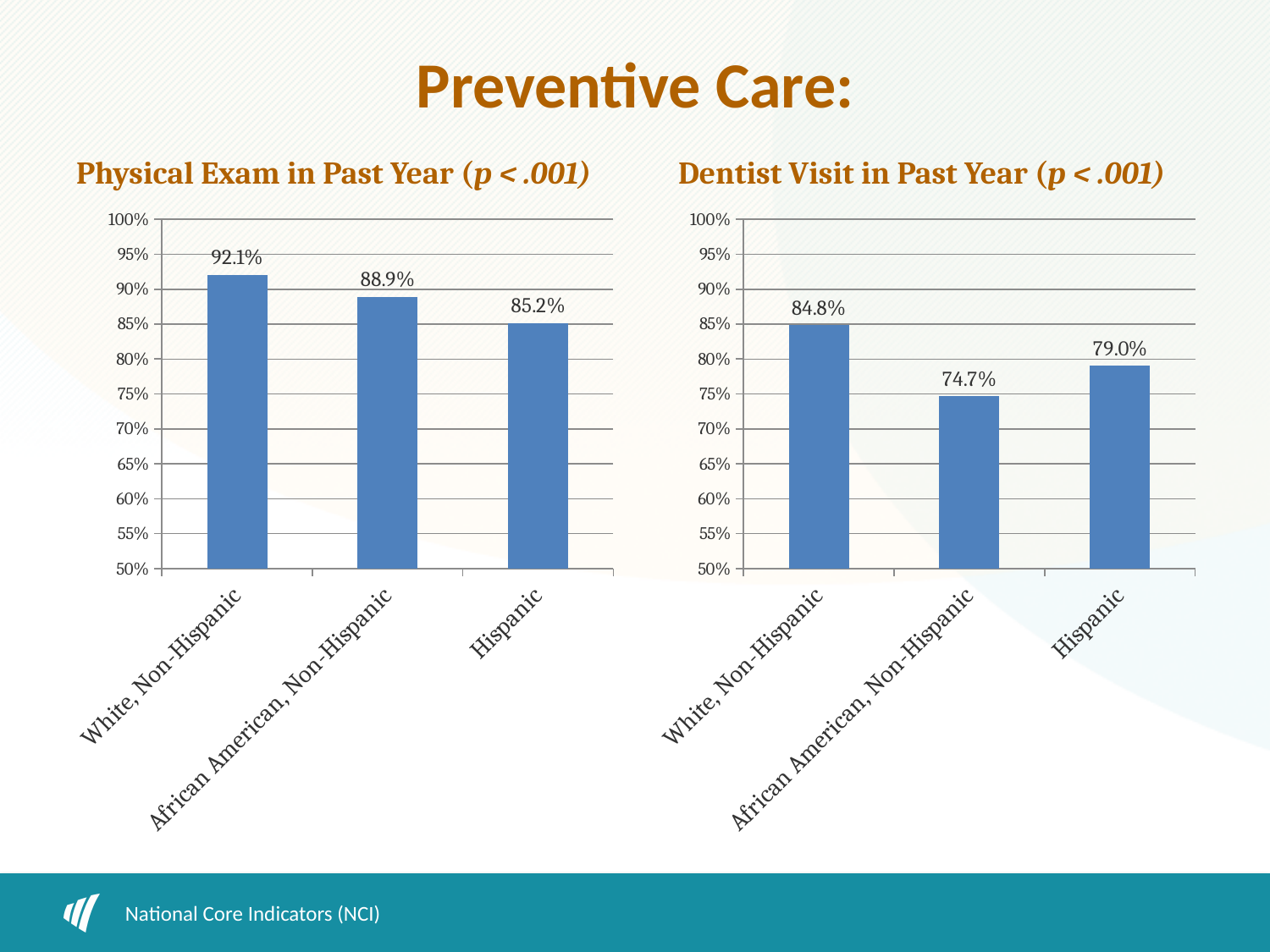
What kind of chart is the 'Dentist Visit in Past Year' chart? Bar chart In the 'Physical Exam in Past Year' chart, which category has the lowest value? Hispanic In the 'Physical Exam in Past Year' chart, what is the value for White, Non-Hispanic? 92.1% In the 'Dentist Visit in Past Year' chart, which category has the lowest value? African American, Non-Hispanic In the 'Dentist Visit in Past Year' chart, which is larger: the value for Hispanic or for African American, Non-Hispanic? Hispanic In the 'Physical Exam in Past Year' chart, what is the difference between the White, Non-Hispanic and Hispanic values? 6.9% In the 'Physical Exam in Past Year' chart, do the values rise or fall from left to right? Fall In the 'Dentist Visit in Past Year' chart, what is the difference between the White, Non-Hispanic and African American, Non-Hispanic values? 10.1% How many categories are shown in the 'Physical Exam in Past Year' chart? 3 In the 'Dentist Visit in Past Year' chart, which category has the highest value? White, Non-Hispanic In the 'Dentist Visit in Past Year' chart, what is the value for Hispanic? 79.0% In the 'Dentist Visit in Past Year' chart, what is the value for African American, Non-Hispanic? 74.7%